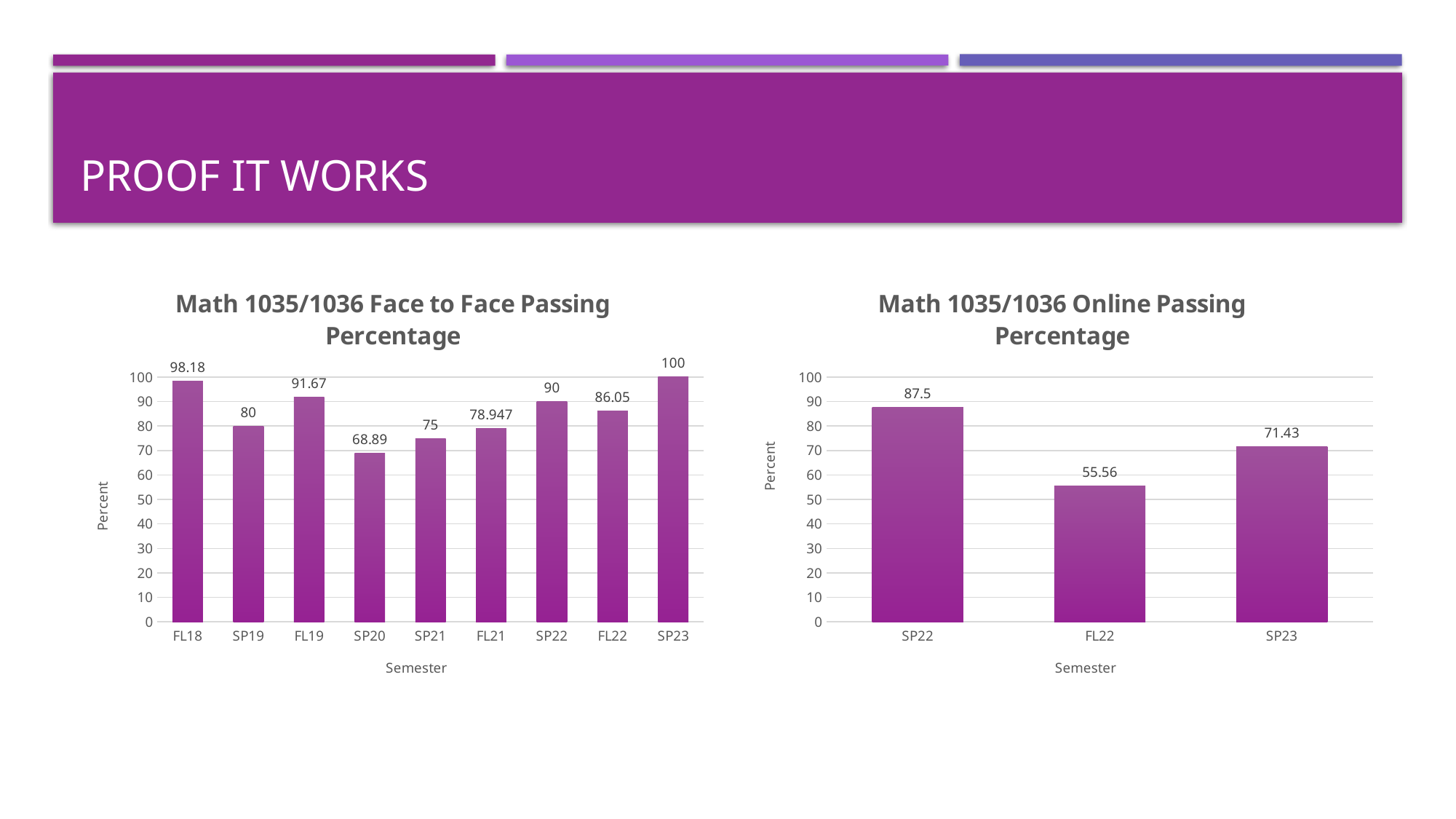
What type of chart is the Math 1035/1036 Online Passing Percentage chart? Bar chart In the Math 1035/1036 Face to Face Passing Percentage chart, what is the value for FL21? 78.947 In the Math 1035/1036 Online Passing Percentage chart, how many semesters are shown? 3 In the Math 1035/1036 Online Passing Percentage chart, which semester has the highest passing percentage? SP22 In the Math 1035/1036 Online Passing Percentage chart, what is the difference between the values for SP22 and SP23? 16.07 In the Math 1035/1036 Online Passing Percentage chart, what is the value for FL22? 55.56 In the Math 1035/1036 Face to Face Passing Percentage chart, which semester has the highest passing percentage? SP23 Which is larger: the SP22 value in the Face to Face chart or the SP22 value in the Online chart? Face to Face In the Math 1035/1036 Face to Face Passing Percentage chart, what is the difference between the values for FL18 and SP19? 18.18 In the Math 1035/1036 Face to Face Passing Percentage chart, which semester has the lowest passing percentage? SP20 In the Math 1035/1036 Face to Face Passing Percentage chart, what is the value for SP20? 68.89 In the Math 1035/1036 Face to Face Passing Percentage chart, how many semesters are shown? 9